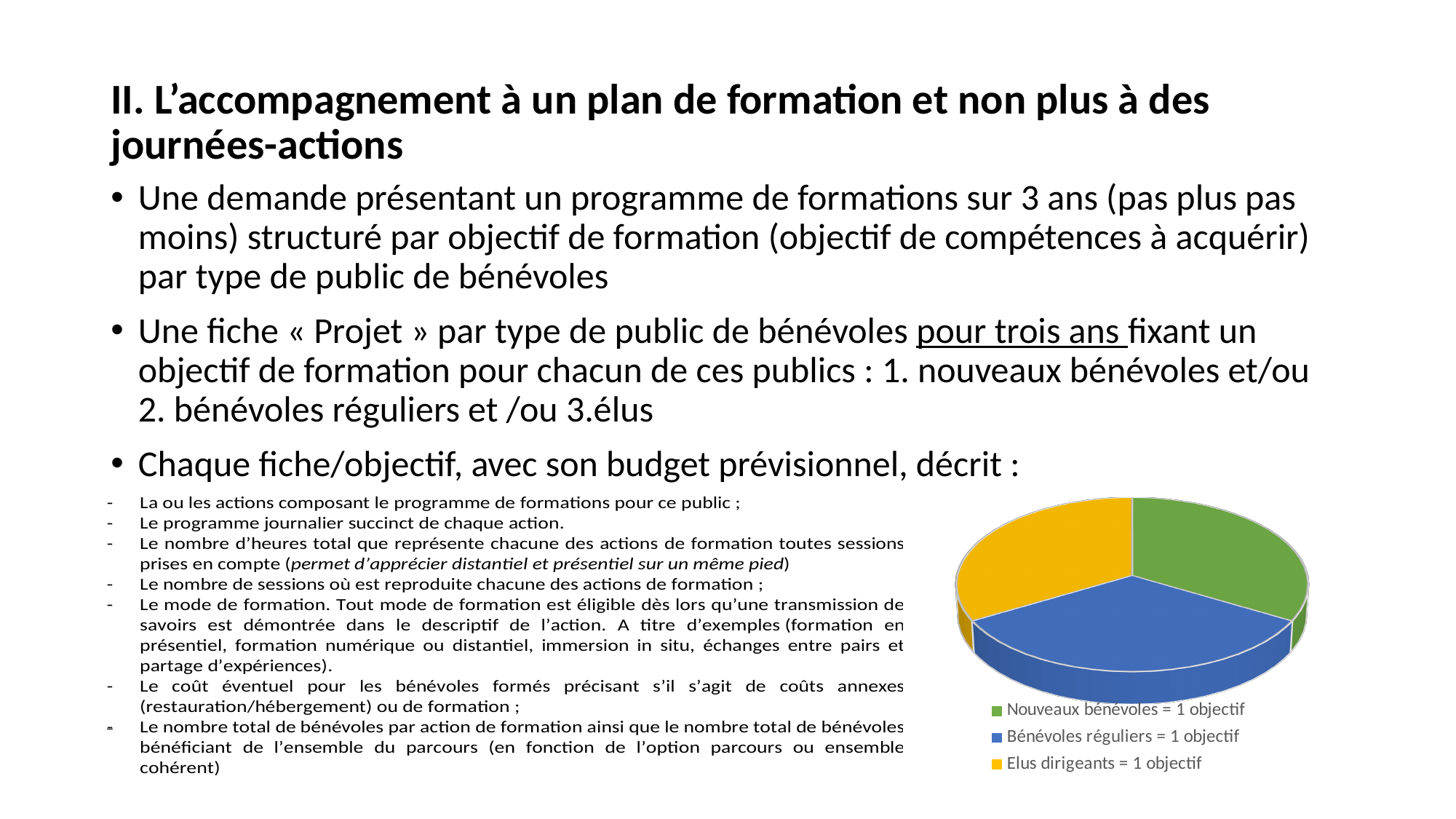
Which colour represents Nouveaux bénévoles in the pie chart? green According to the legend, what value is given for Elus dirigeants? 1 objectif What kind of chart is shown on the slide? pie chart Which category is shown in yellow in the pie chart? Elus dirigeants According to the legend, what value is given for Bénévoles réguliers? 1 objectif How many slices does the pie chart have? 3 How many entries does the legend of the pie chart list? 3 According to the legend, what value is given for Nouveaux bénévoles? 1 objectif